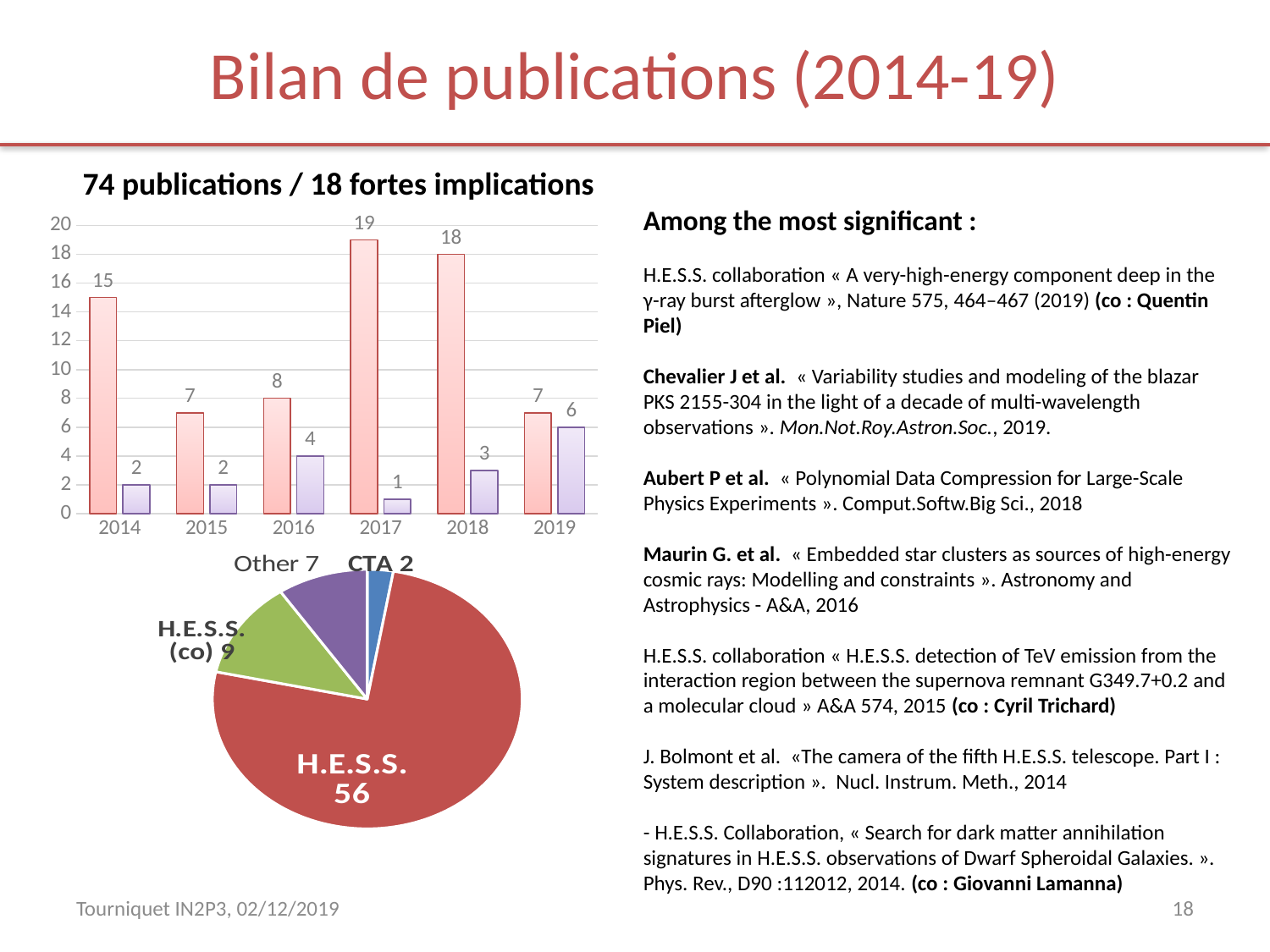
How many slices does the pie chart have? 4 In the pie chart, which category has the smallest slice? CTA In the bar chart, which year has the lowest purple bar? 2017 In the bar chart, what is the value of the purple bar for 2019? 6 In the pie chart, what is the value of the H.E.S.S. slice? 56 What type of chart is the top chart on the slide? bar chart In the bar chart, what is the difference between the red bar for 2014 and the red bar for 2015? 8 In the bar chart, which is larger: the purple bar for 2016 or the purple bar for 2018? 2016 In the bar chart, what is the value of the red bar for 2017? 19 In the bar chart, which year has the highest red bar? 2017 How many years are shown on the x axis of the bar chart? 6 What is the title of the bar chart? 74 publications / 18 fortes implications